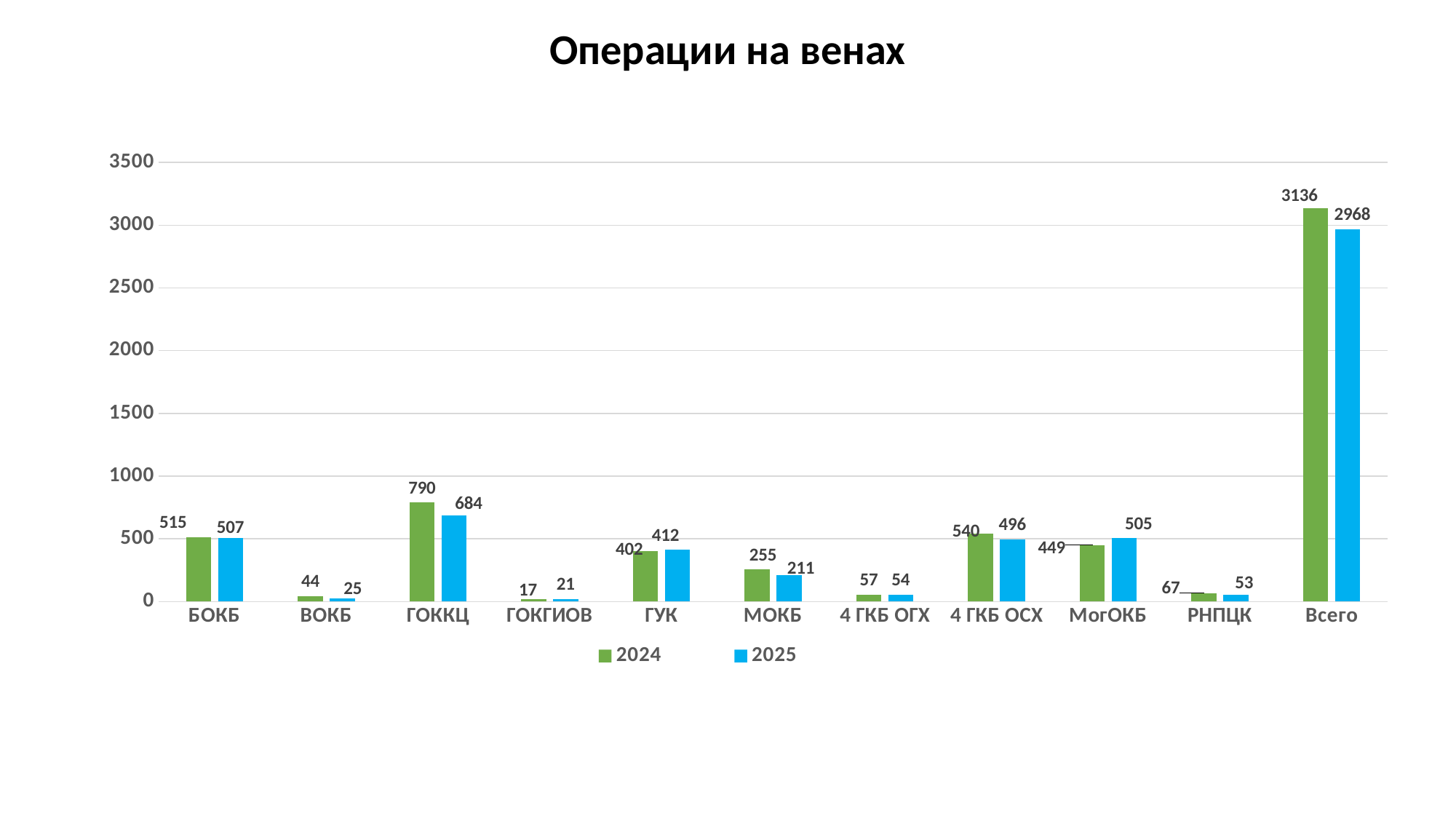
What is the difference between the 2024 and 2025 values for Всего? 168 How many categories are shown on the x axis? 11 Which is larger for МогОКБ, the 2024 value or the 2025 value? 2025 What kind of chart is shown? bar chart What is the 2025 value for Всего? 2968 Excluding Всего, which category has the highest 2024 value? ГОККЦ What is the title of the chart? Операции на венах Which category has the lowest 2025 value? ГОКГИОВ What is the 2025 value for МогОКБ? 505 How many series does the legend list? 2 What is the difference between the 2024 and 2025 values for МОКБ? 44 What is the 2024 value for ГОККЦ? 790